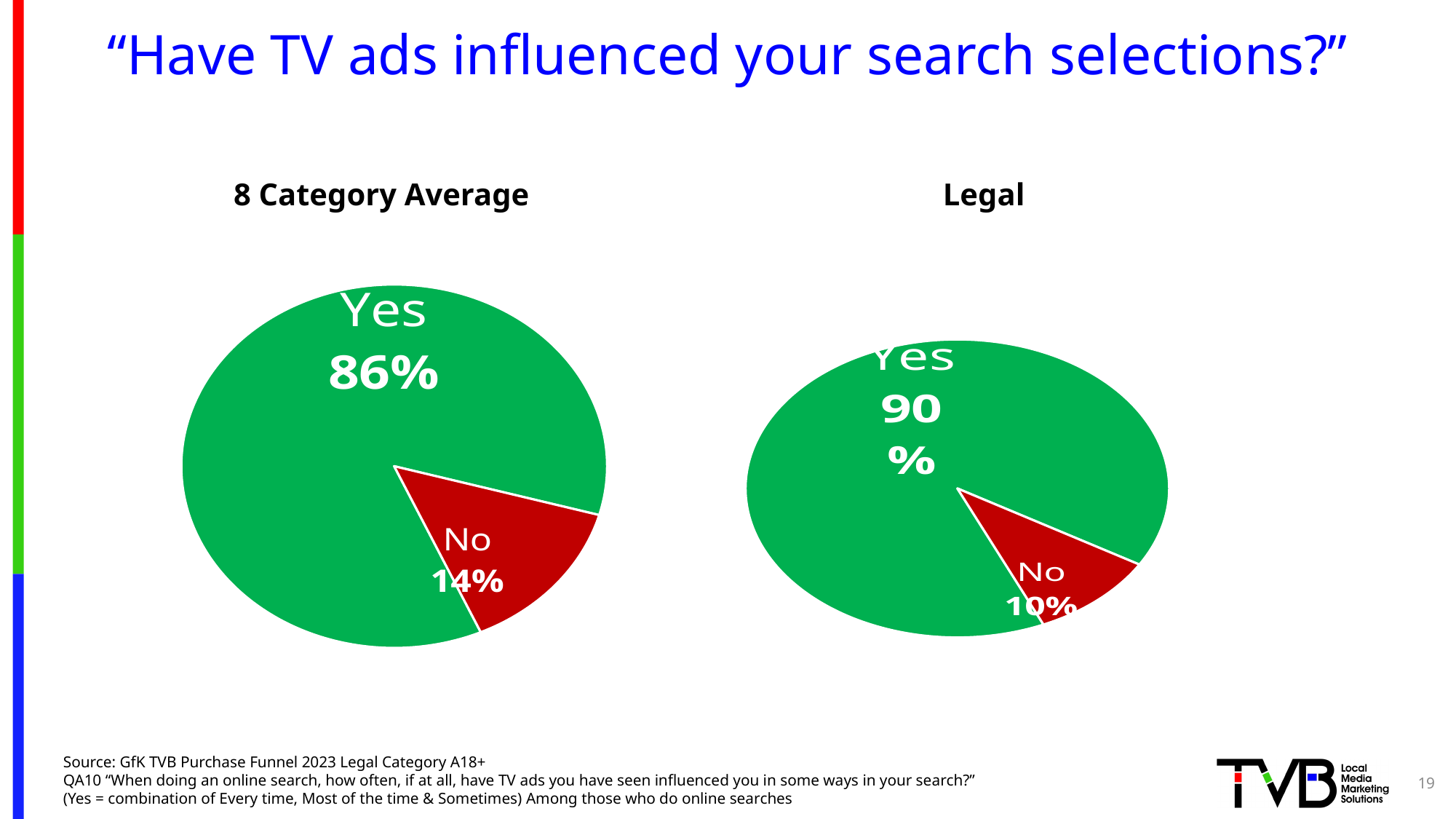
In the 'Legal' pie chart, what percentage answered No? 10% In the '8 Category Average' pie chart, what percentage answered No? 14% What type of chart is used for the '8 Category Average' data? Pie chart In the 'Legal' pie chart, what colour is the No slice? Red Which chart has the larger No share, '8 Category Average' or 'Legal'? 8 Category Average How many slices does the 'Legal' pie chart have? 2 What is the difference between the Yes share in the 'Legal' chart and the Yes share in the '8 Category Average' chart? 4% In the '8 Category Average' pie chart, which slice is the smallest? No In the 'Legal' pie chart, which slice is the largest? Yes In the 'Legal' pie chart, what percentage answered Yes? 90% How many pie charts are shown on the slide? 2 In the '8 Category Average' pie chart, what percentage answered Yes? 86%